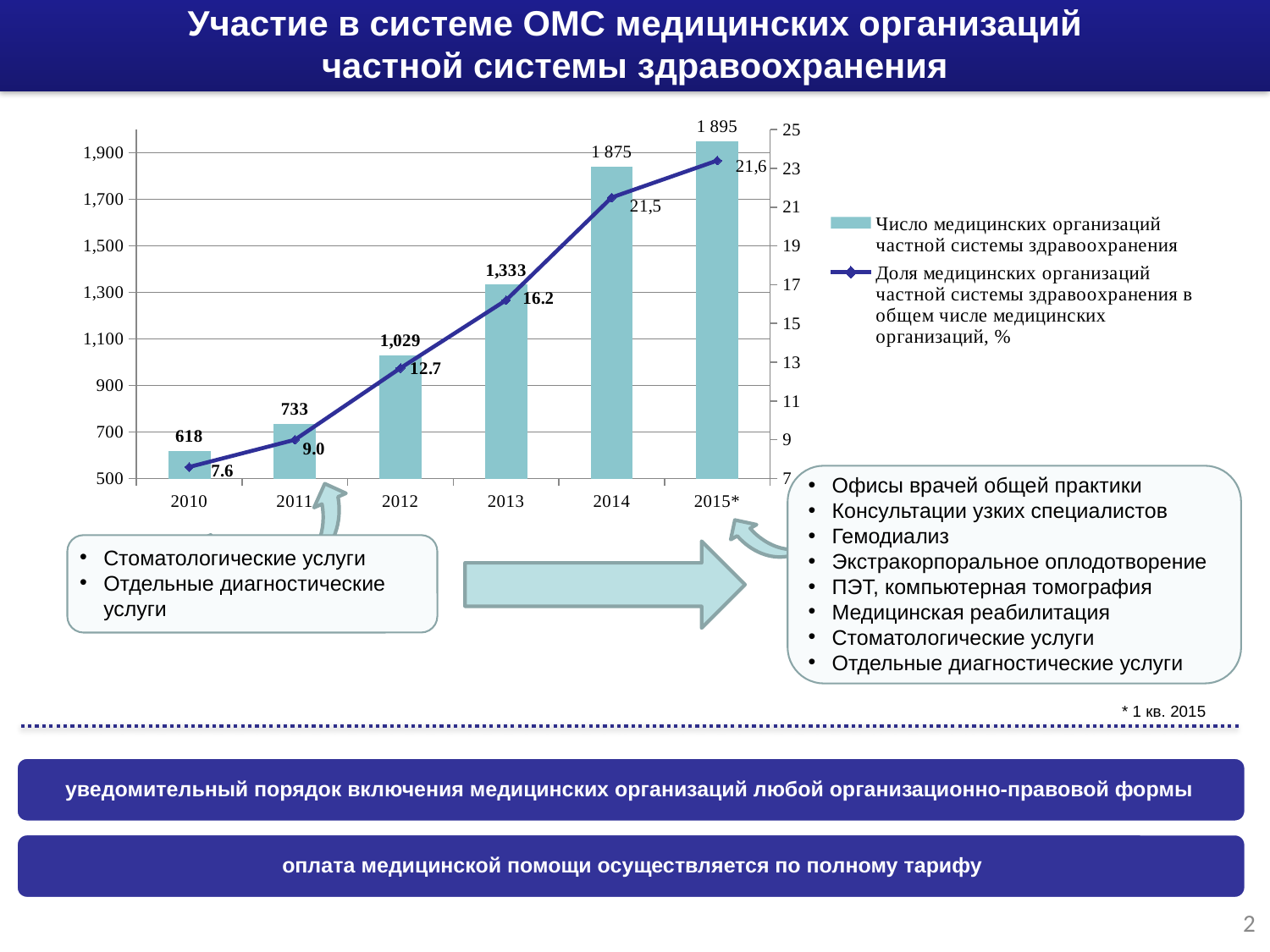
Does the number of private healthcare medical organizations rise or fall from 2010 to 2015*? rise Which year has the lowest number of private healthcare medical organizations? 2010 What is the number of private healthcare medical organizations shown for 2012? 1,029 By how much did the number of private healthcare medical organizations increase from 2010 to 2011? 115 Which year has the highest number of private healthcare medical organizations? 2015* What is the difference in the share (%) between 2013 and 2012? 3.5 What share (%) is shown for 2015* on the line series? 21,6 What is the number of private healthcare medical organizations shown for 2014? 1 875 Which is larger: the number of organizations in 2013 or in 2012? 2013 What share of medical organizations (%) is shown for 2013 on the line series? 16.2 How many series does the chart legend list? 2 How many years are shown on the x axis of the chart? 6